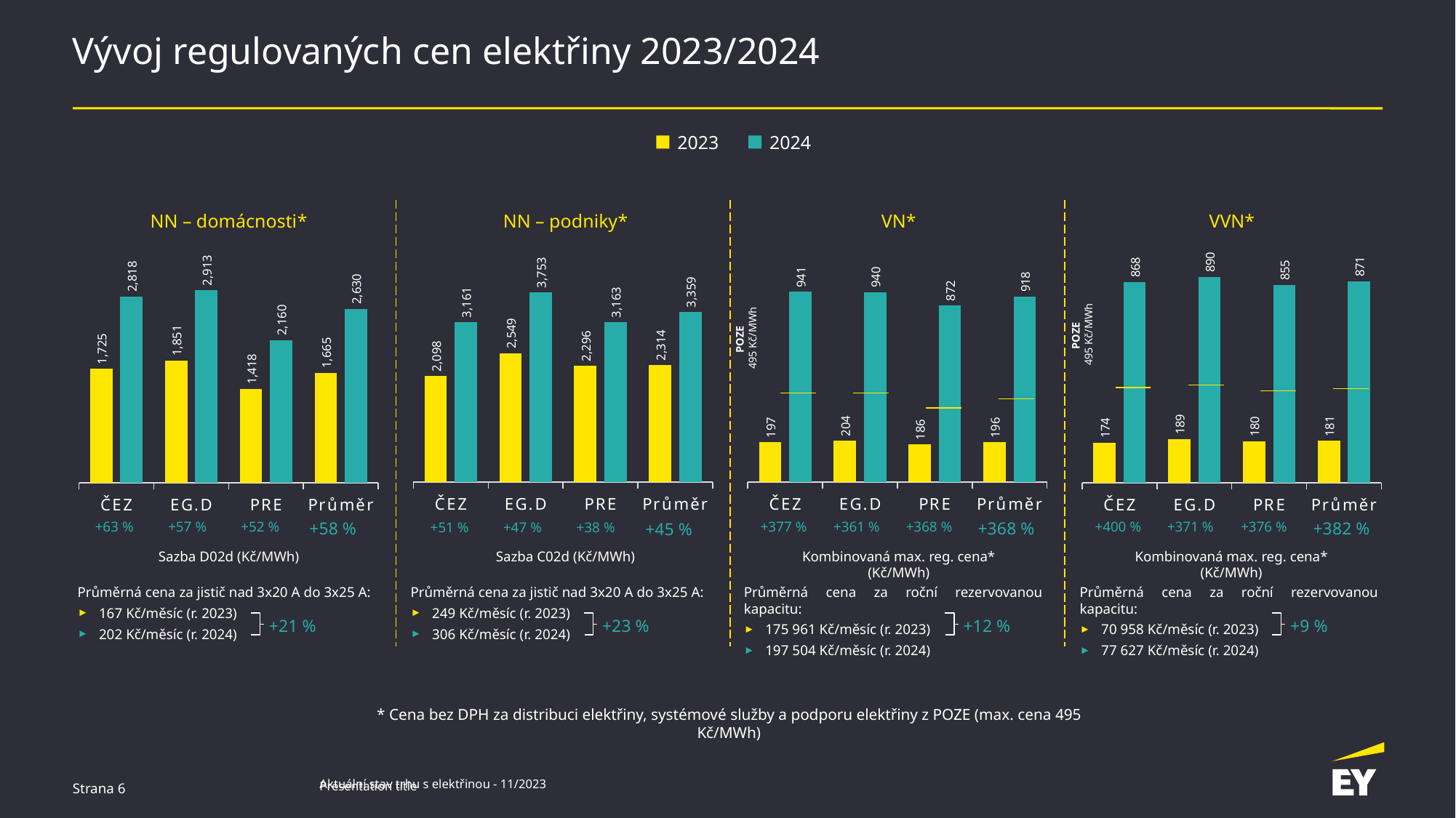
In the NN – podniky chart, which category has the highest 2024 value? EG.D In the VVN chart, which category has the highest 2024 value? EG.D How many categories are shown in the VN chart? 4 What kind of chart is used for NN – domácnosti? Bar chart In the NN – domácnosti chart, what is the 2024 value for EG.D? 2,913 In the VN chart, which is larger: the 2023 value for ČEZ or the 2023 value for EG.D? EG.D In the NN – domácnosti chart, which category has the lowest 2023 value? PRE In the NN – podniky chart, what is the 2023 value for ČEZ? 2,098 In the VVN chart, what is the 2023 value for ČEZ? 174 How many series does the legend list? 2 In the NN – podniky chart, what is the difference between the 2024 and 2023 values for Průměr? 1,045 In the VN chart, what is the 2024 value for PRE? 872